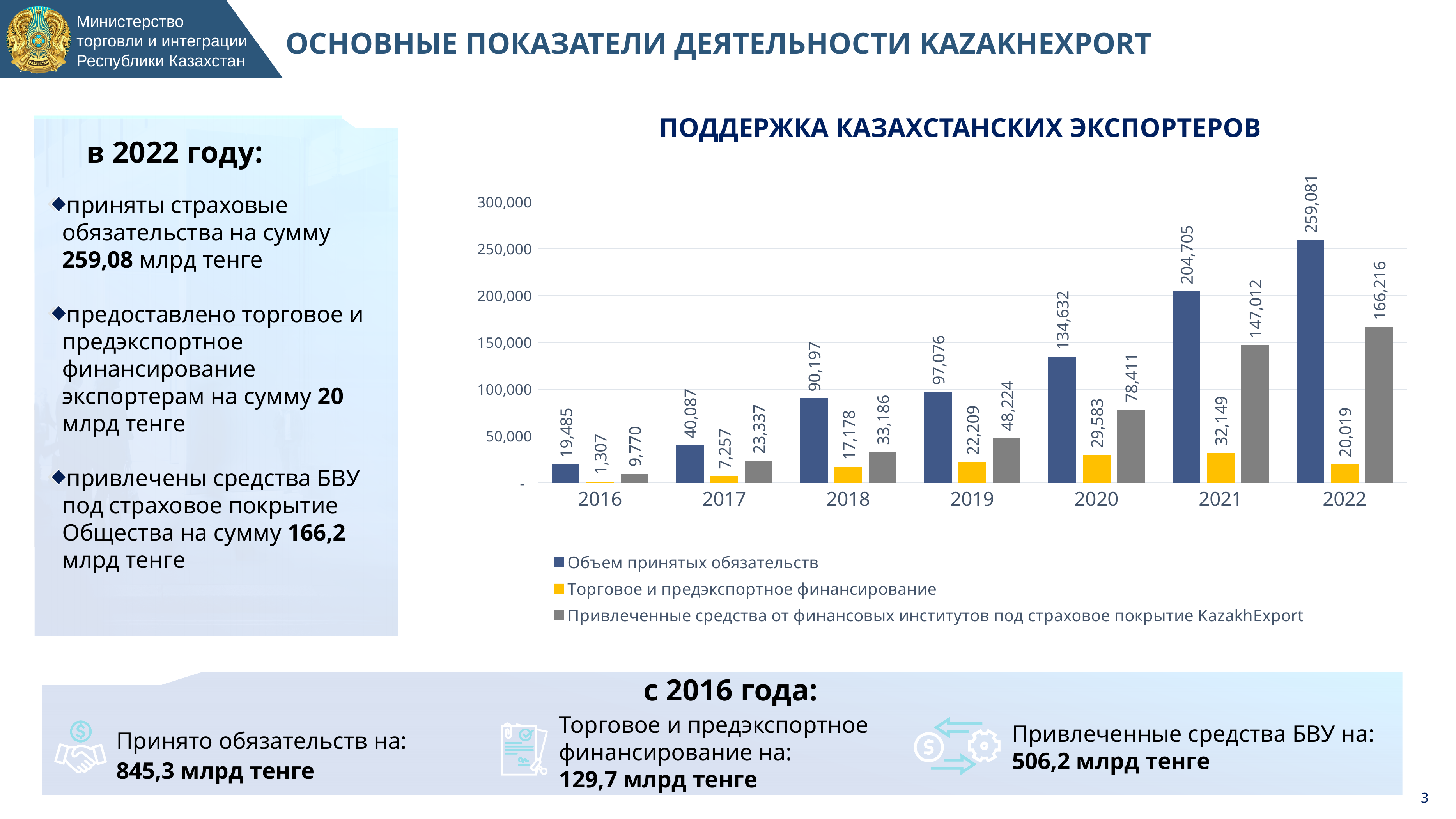
How many series does the chart legend list? 3 In which year is Торговое и предэкспортное финансирование the lowest? 2016 What is the value of Объем принятых обязательств for 2022? 259,081 What is the value of Привлеченные средства от финансовых институтов под страховое покрытие KazakhExport for 2021? 147,012 Is the value of Объем принятых обязательств for 2020 greater or less than 100,000? greater Which is larger: Торговое и предэкспортное финансирование in 2021 or in 2022? 2021 In which year is Объем принятых обязательств the highest? 2022 What type of chart is shown on the slide? bar chart What is the difference between Объем принятых обязательств in 2022 and in 2021? 54,376 Does Объем принятых обязательств rise or fall from 2016 to 2022? rise What is the value of Торговое и предэкспортное финансирование for 2019? 22,209 How many years are shown on the x axis of the chart? 7